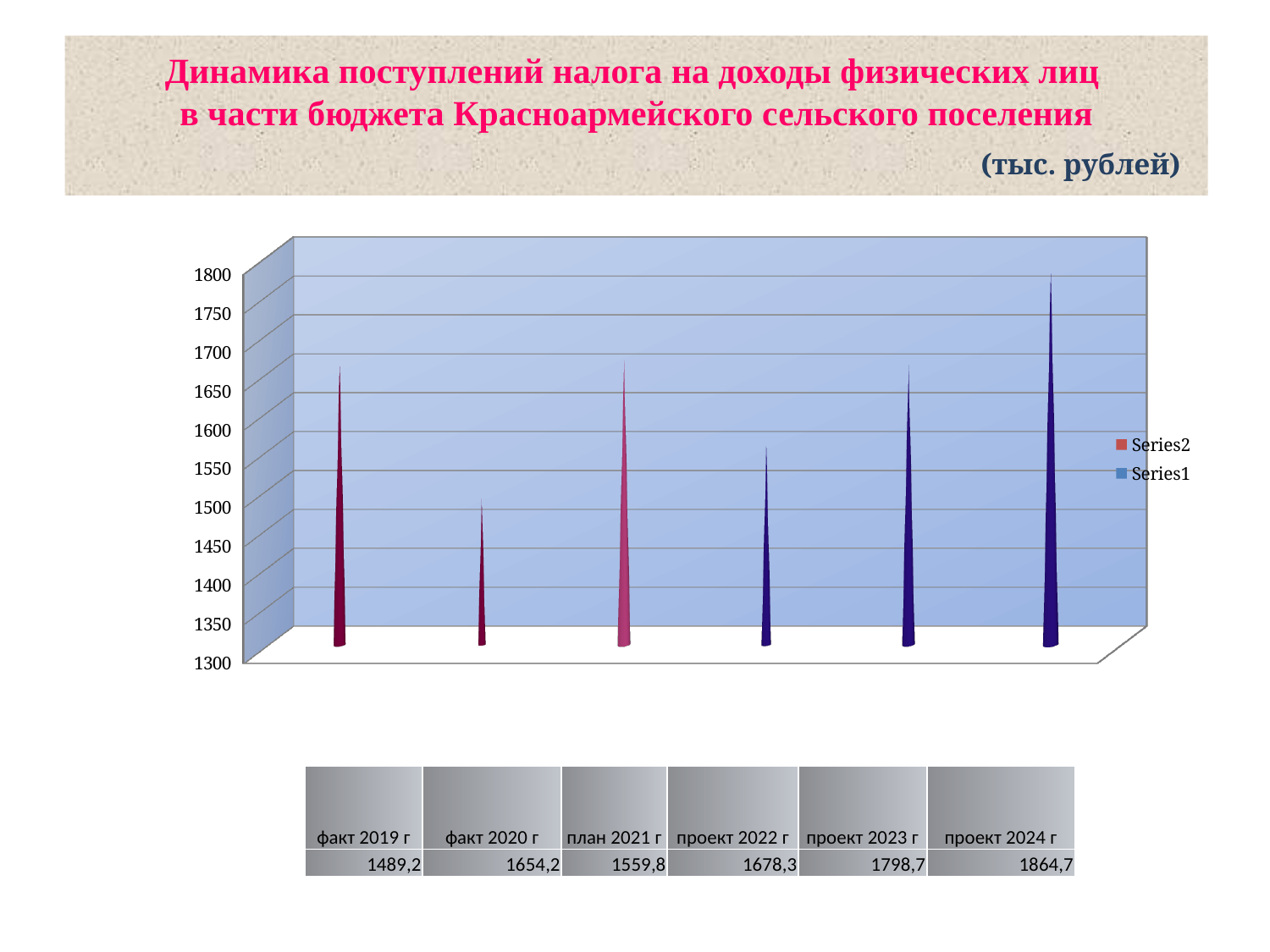
What is the value for факт 2019 г? 1489,2 Which category has the lowest value? факт 2019 г What is the difference between the values for факт 2020 г and факт 2019 г? 165 What unit is stated in the chart title? тыс. рублей What is the value for проект 2023 г? 1798,7 How many categories are shown in the chart? 6 What is the value for план 2021 г? 1559,8 Which category has the highest value? проект 2024 г How many series does the legend list? 2 Which is larger, the value for факт 2020 г or the value for план 2021 г? факт 2020 г What kind of chart is shown on the slide? bar chart What is the difference between the values for проект 2024 г and проект 2023 г? 66